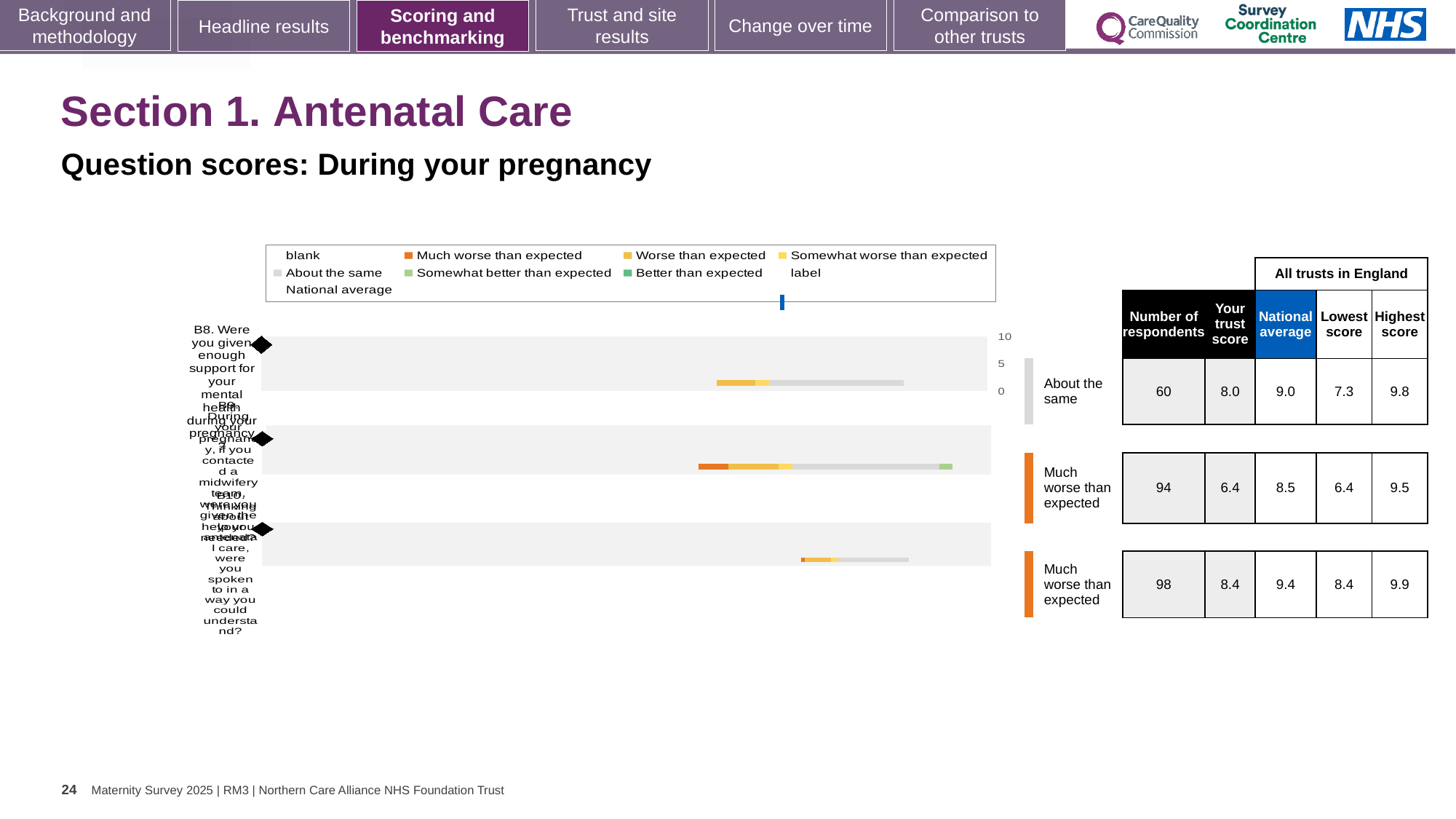
Which row of the table has the largest number of respondents? the third row (98) In the second row of the table, what is the difference between the national average and the trust score? 2.1 In the table, what is the national average for the third row? 9.4 Is the trust score larger in the first row or the third row of the table? the third row What kind of chart is shown on the slide? bar chart What is the benchmark rating shown next to the second bar? Much worse than expected In the table, what is the number of respondents for the first row (rated 'About the same')? 60 What is the benchmark rating shown next to the first (top) bar? About the same Which legend entry is shown in dark orange? Much worse than expected In the table, what is the highest score for the first row? 9.8 How many question bars are plotted in the chart? 3 In the table, what is the trust score for the second row? 6.4